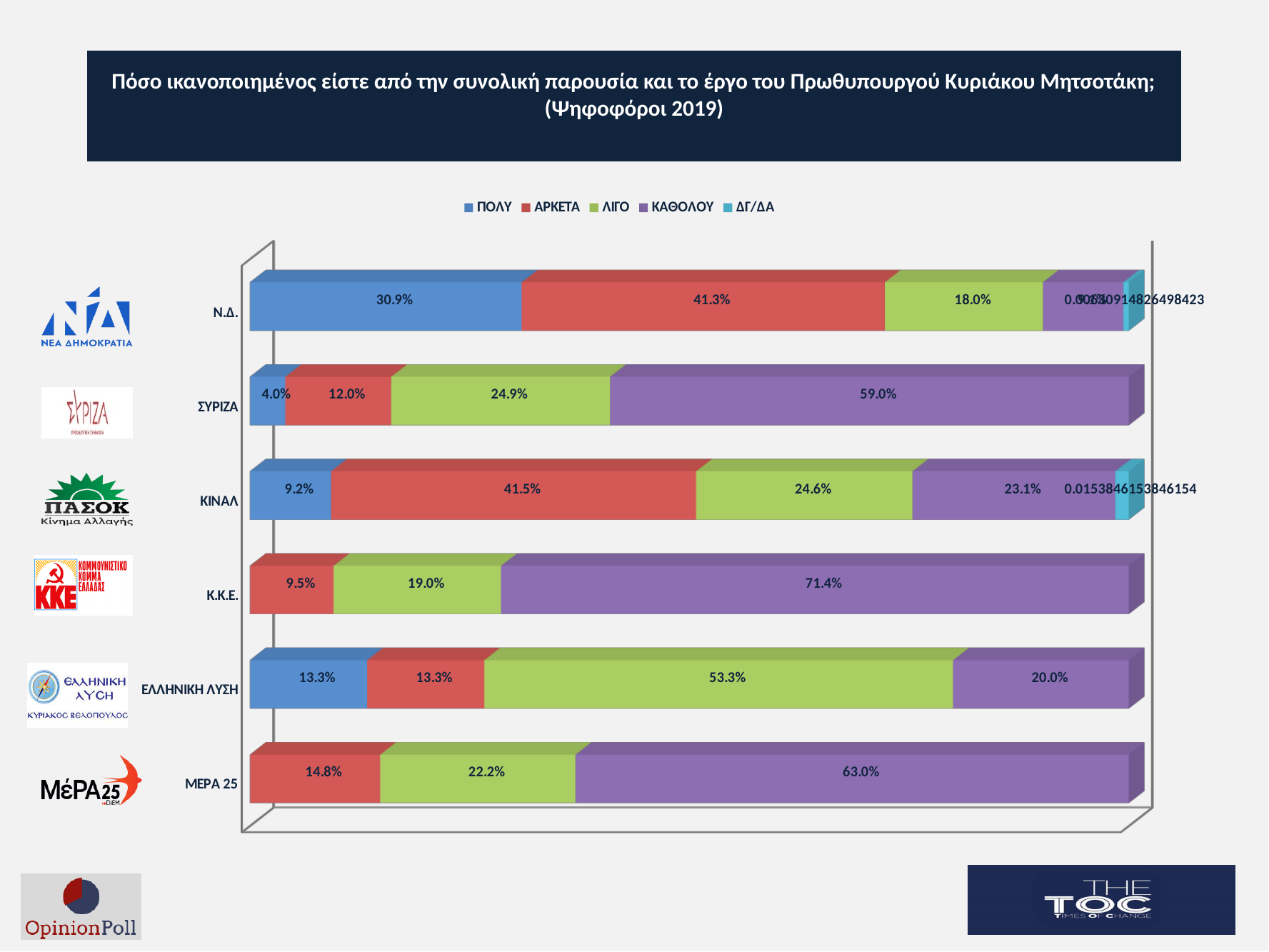
Which colour represents ΚΑΘΟΛΟΥ in the legend? Purple Which is larger: the ΑΡΚΕΤΑ value for Ν.Δ. or the ΑΡΚΕΤΑ value for ΚΙΝΑΛ? ΚΙΝΑΛ What is the difference between the ΚΑΘΟΛΟΥ values for ΜΕΡΑ 25 and ΣΥΡΙΖΑ? 4.0% How many parties are shown on the chart? 6 What percentage of ΣΥΡΙΖΑ voters answered ΚΑΘΟΛΟΥ? 59.0% How many series does the legend list? 5 Which party's voters have the lowest ΠΟΛΥ share among those with a ΠΟΛΥ label? ΣΥΡΙΖΑ What kind of chart is shown on the slide? Stacked bar chart What is the ΛΙΓΟ value for ΕΛΛΗΝΙΚΗ ΛΥΣΗ? 53.3% What is the ΠΟΛΥ value for Ν.Δ.? 30.9% Which party's voters have the highest ΚΑΘΟΛΟΥ share? Κ.Κ.Ε. What is the ΑΡΚΕΤΑ value for ΚΙΝΑΛ? 41.5%